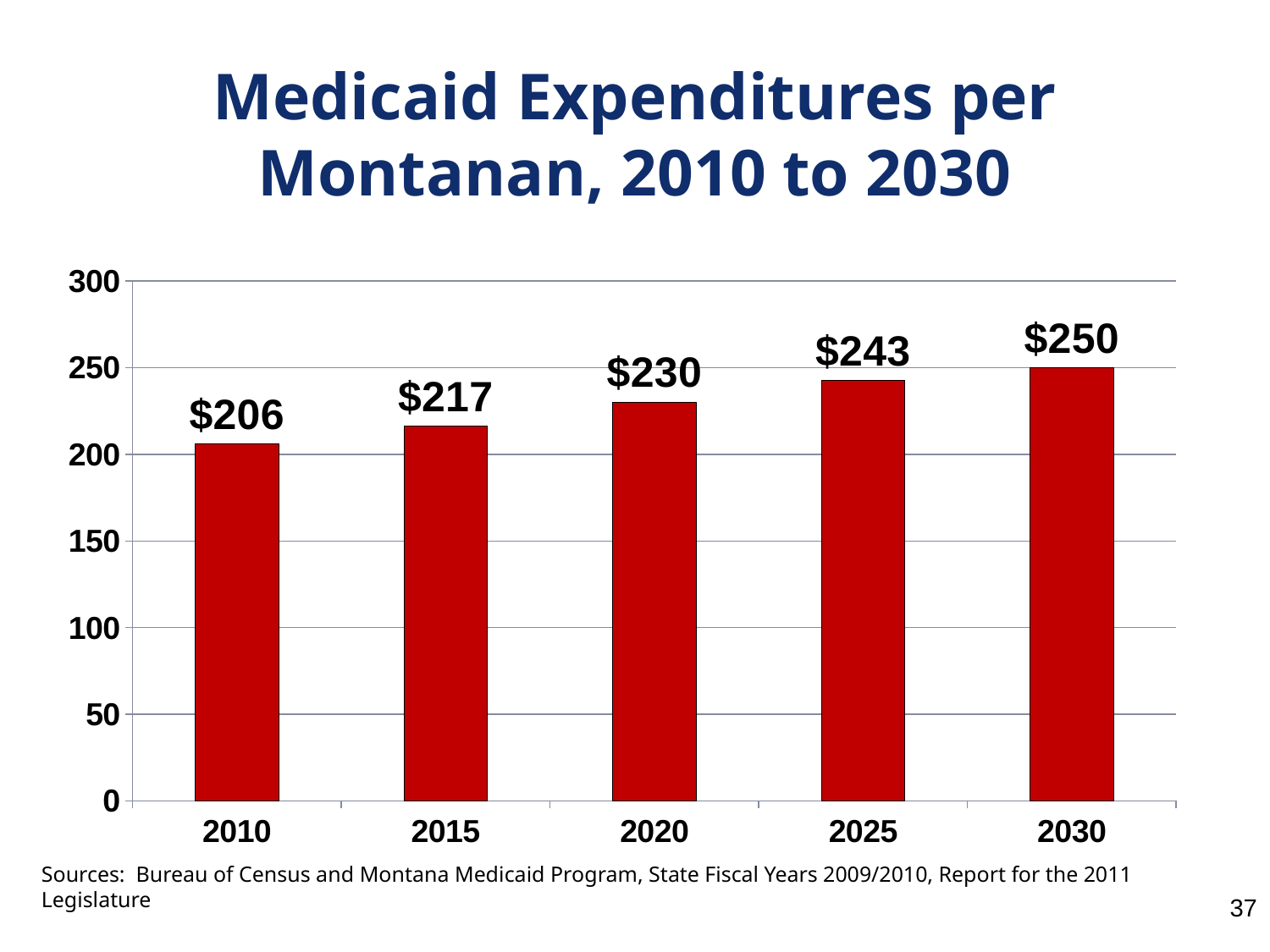
What is the Medicaid expenditure per Montanan in 2030? $250 Which year has the lowest Medicaid expenditure per Montanan? 2010 What kind of chart is shown on the slide? bar chart Which year has the highest Medicaid expenditure per Montanan? 2030 How many years are shown on the chart? 5 What is the Medicaid expenditure per Montanan in 2010? $206 What is the difference between the 2025 and 2015 values? $26 Is the value for 2020 greater or less than 250? less Which is larger, the value for 2015 or the value for 2025? 2025 What is the Medicaid expenditure per Montanan in 2020? $230 Do the values rise or fall from 2010 to 2030? rise What is the difference between the 2030 and 2010 values? $44